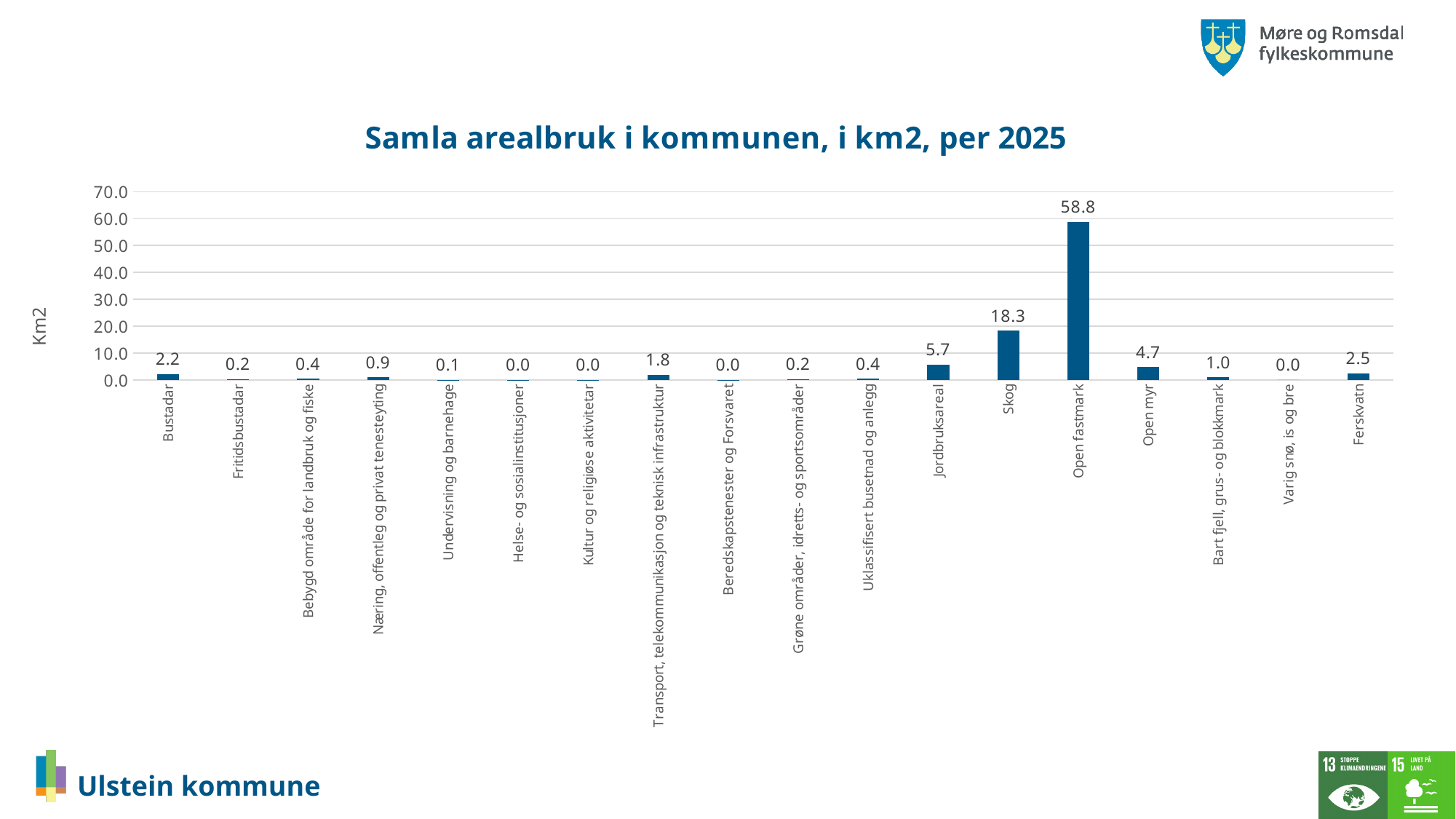
What kind of chart is shown on the slide? bar chart Which category has the highest value? Open fastmark What is the difference between the values for Open fastmark and Skog? 40.5 How many categories are shown on the x axis? 18 What is the value for Skog? 18.3 Which is larger, the value for Open myr or the value for Jordbruksareal? Jordbruksareal What is the value for Bustadar? 2.2 What is the title of the chart? Samla arealbruk i kommunen, i km2, per 2025 Is the value for Skog greater or less than 20.0? less What is the value for Ferskvatn? 2.5 What is the value for Jordbruksareal? 5.7 What is the value for Open fastmark? 58.8